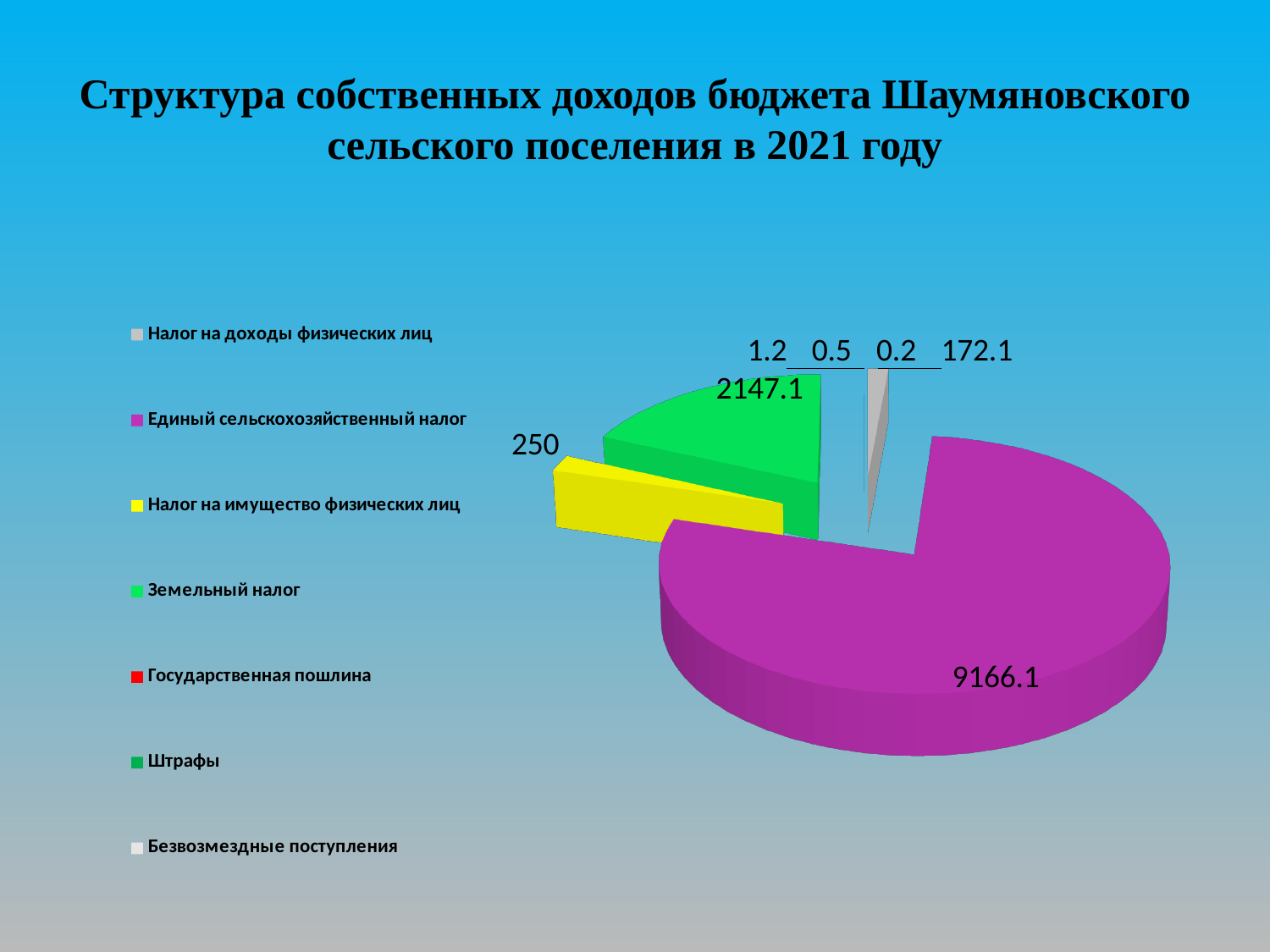
What colour is the slice for Единый сельскохозяйственный налог? Magenta (purple) What kind of chart is shown on the slide? Pie chart What is the difference between the values for Единый сельскохозяйственный налог and Земельный налог? 7019 What year does the chart title refer to? 2021 What is the value shown for Налог на доходы физических лиц? 172.1 Which is larger: Земельный налог or Налог на имущество физических лиц? Земельный налог What is the value shown for Земельный налог? 2147.1 What is the value shown for Налог на имущество физических лиц? 250 Which category has the largest slice of the pie? Единый сельскохозяйственный налог What is the value shown for Единый сельскохозяйственный налог? 9166.1 How many categories does the legend of the pie chart list? 7 What is the difference between the values for Налог на имущество физических лиц and Налог на доходы физических лиц? 77.9